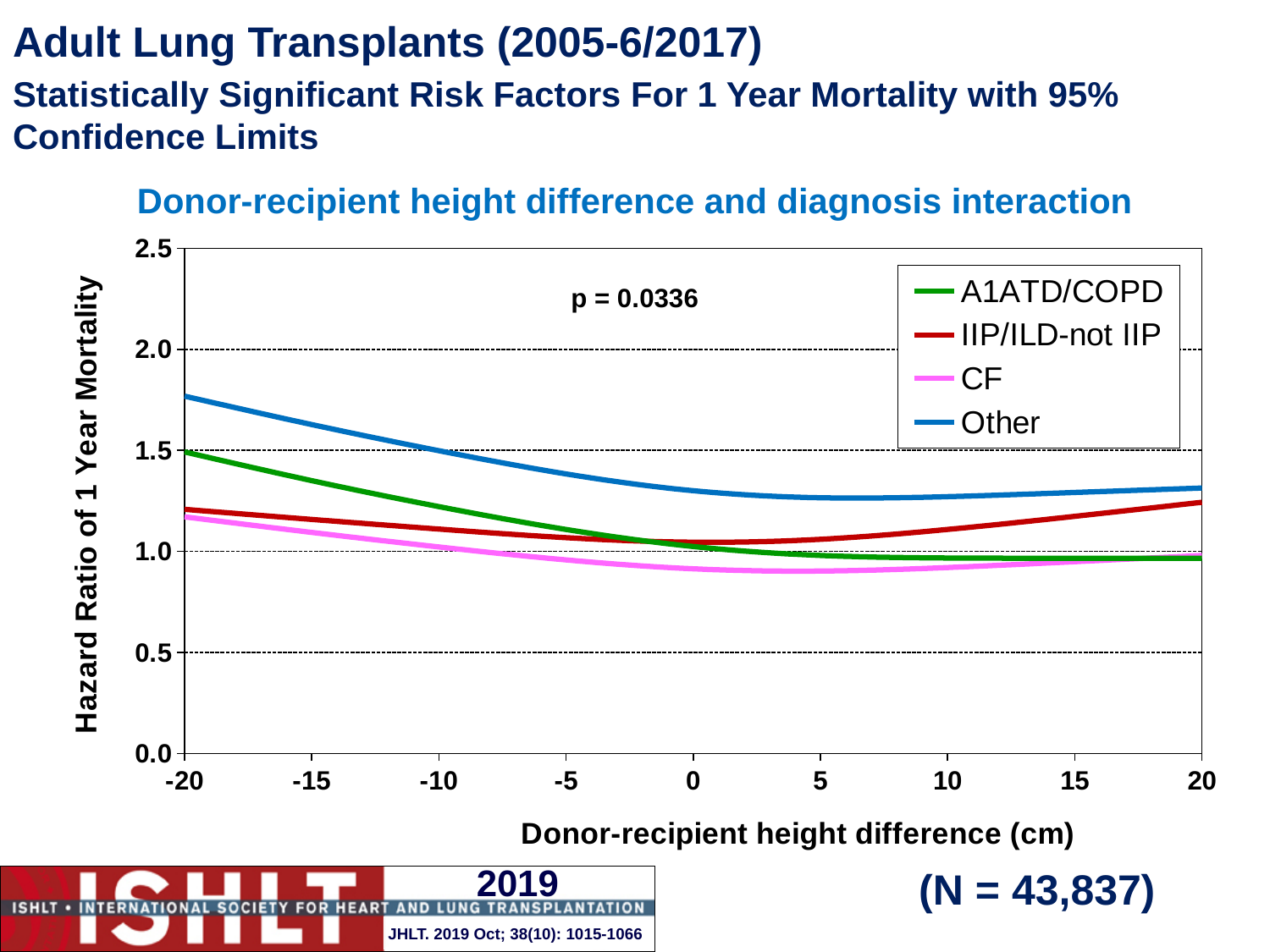
Does the hazard ratio for the Other series rise or fall as the height difference goes from -20 cm to 5 cm? fall Is the hazard ratio for the Other series at 5 cm greater or less than 1.5? less Is the hazard ratio for the Other series at -20 cm greater or less than 1.5? greater How many series does the legend list? 4 Which series has the highest hazard ratio at a donor-recipient height difference of -20 cm? Other What p-value is printed on the chart? p = 0.0336 Which series has the lowest hazard ratio at a donor-recipient height difference of 0 cm? CF Is the hazard ratio for the CF series at 0 cm greater or less than 1.0? less At a height difference of -20 cm, which series has the larger hazard ratio, A1ATD/COPD or IIP/ILD-not IIP? A1ATD/COPD What is the title of the chart? Donor-recipient height difference and diagnosis interaction What kind of chart is shown on the slide? line chart